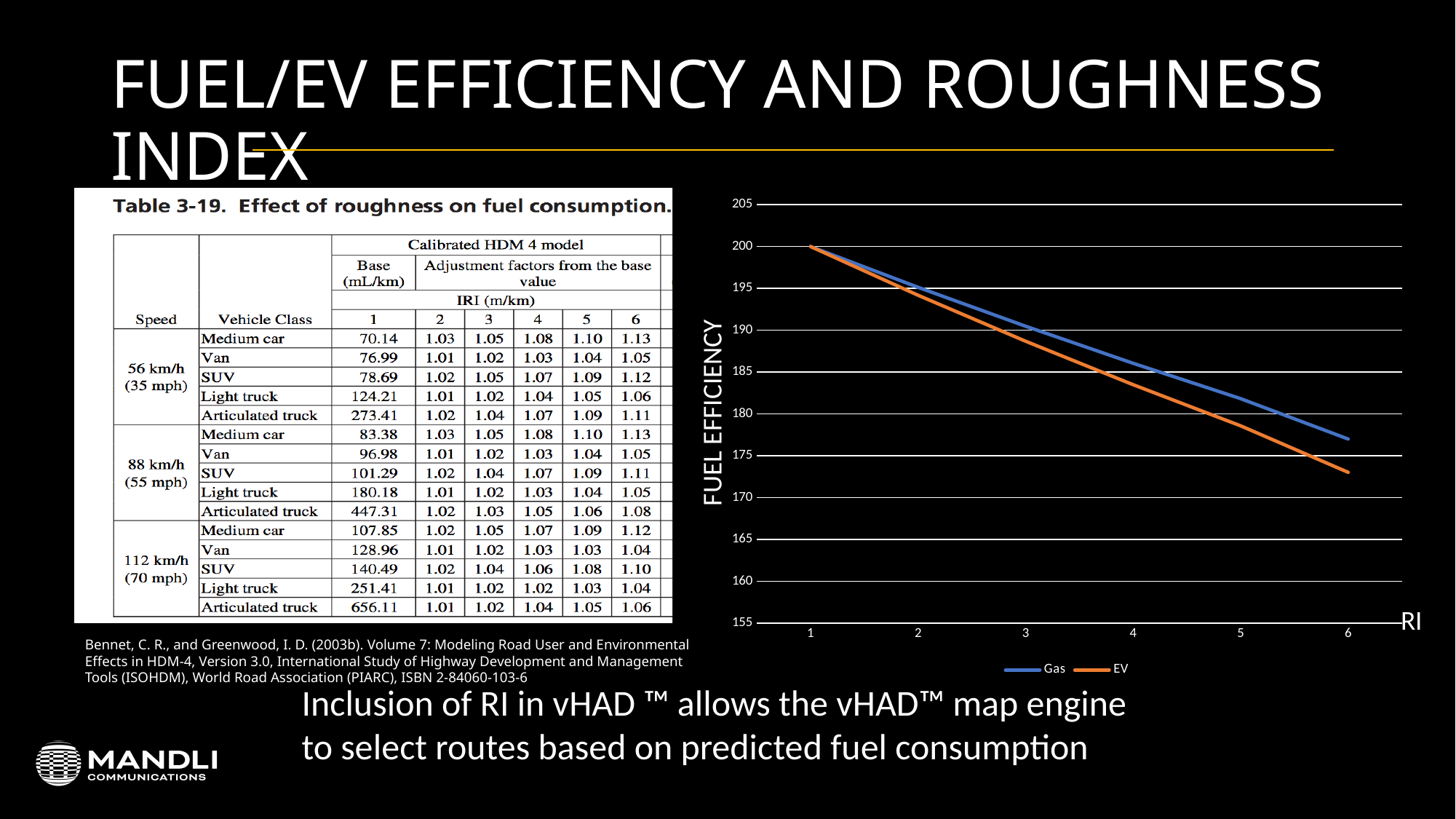
What is the label of the vertical axis of the chart? FUEL EFFICIENCY Which series shows the steeper decline in fuel efficiency across the RI range, Gas or EV? EV Is the fuel efficiency value for Gas at RI = 6 greater or less than 175? greater Do the Gas and EV lines rise or fall as RI increases from 1 to 6? fall What fuel efficiency value do both the Gas and EV lines start at when RI is 1? 200 Is the fuel efficiency value for EV at RI = 6 greater or less than 175? less How many RI values are marked along the x axis of the chart? 6 What are the two series named in the chart legend? Gas and EV Is the fuel efficiency value for EV at RI = 4 greater or less than 190? less How many series does the chart legend list? 2 At RI = 6, which series has the higher fuel efficiency, Gas or EV? Gas What kind of chart is shown on the right of the slide? line chart